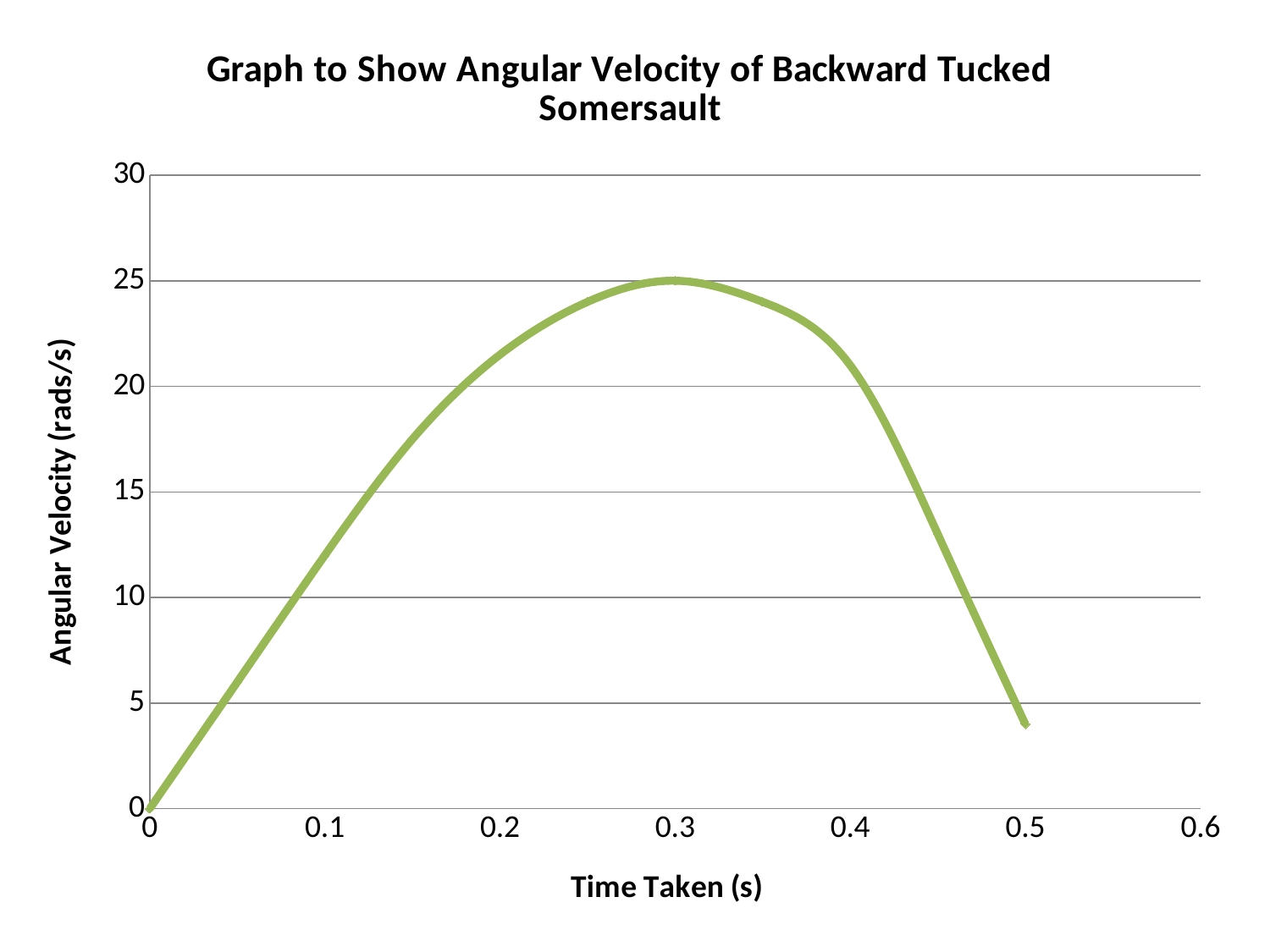
Is the angular velocity at time 0.1 greater or less than 10? greater Does the angular velocity rise or fall between time 0.3 and time 0.5? fall Which is larger, the angular velocity at time 0.1 or at time 0.5? 0.1 What is the title of the chart? Graph to Show Angular Velocity of Backward Tucked Somersault What is the angular velocity at time 0? 0 What is the peak angular velocity reached at time 0.3? 25 Is the angular velocity at time 0.2 greater or less than 15? greater What kind of chart is shown on the slide? line chart At what time does the angular velocity reach its highest value? 0.3 Is the angular velocity at time 0.4 greater or less than 20? greater What is the label of the y axis? Angular Velocity (rads/s)